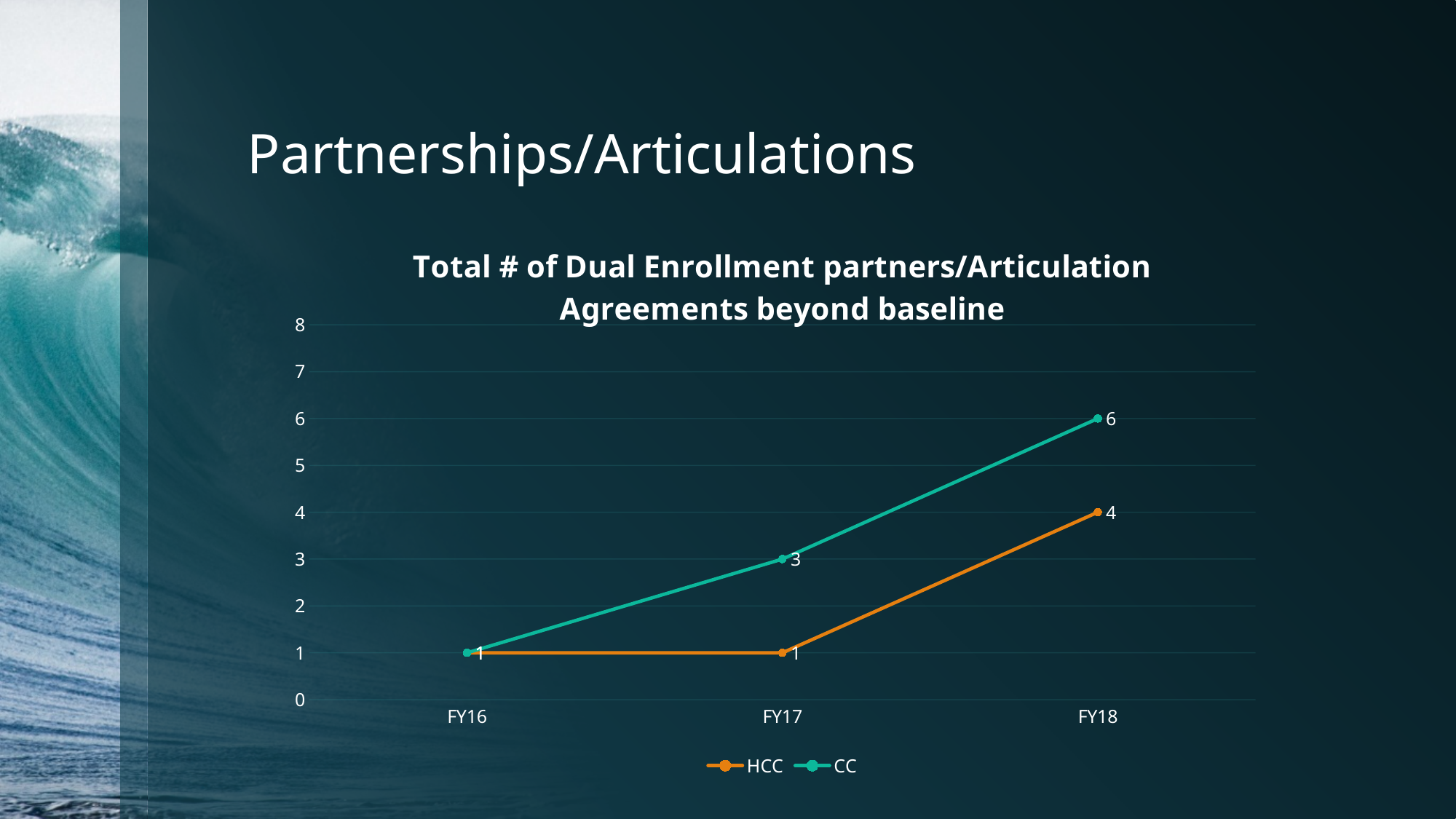
What is the value for CC in FY18? 6 How many series does the legend list? 2 In which fiscal year is the CC value highest? FY18 What is the value for CC in FY17? 3 What is the value for HCC in FY18? 4 How many fiscal years are shown on the x axis? 3 What is the value for HCC in FY17? 1 What kind of chart is shown on the slide? line chart Does the CC line rise or fall from FY16 to FY18? rise Which series has the larger value in FY17, HCC or CC? CC What is the difference between the CC and HCC values in FY18? 2 What is the title of the chart? Total # of Dual Enrollment partners/Articulation Agreements beyond baseline